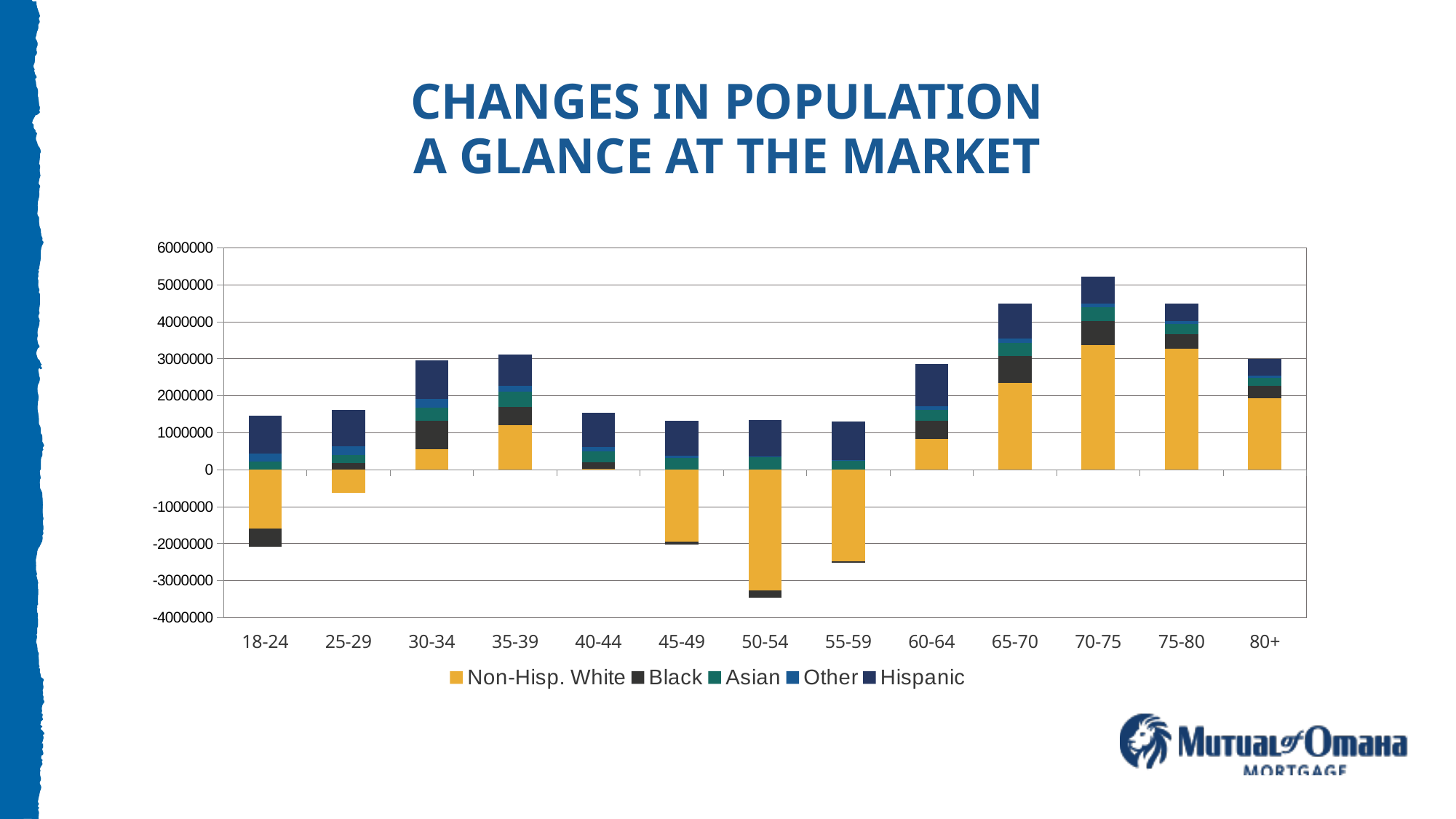
What kind of chart is shown on the slide? Stacked bar chart How many age groups are shown on the x axis? 13 Is the Non-Hisp. White value for 65-70 greater or less than 2000000? greater Is the Non-Hisp. White value for 50-54 greater or less than -3000000? less Is the Non-Hisp. White value for 55-59 greater or less than -2000000? less Which age group has the tallest positive stacked bar? 70-75 Which age group has the most negative Non-Hisp. White value? 50-54 Which series is listed first in the legend? Non-Hisp. White Which has the larger Non-Hisp. White value, 65-70 or 75-80? 75-80 How many series does the legend list? 5